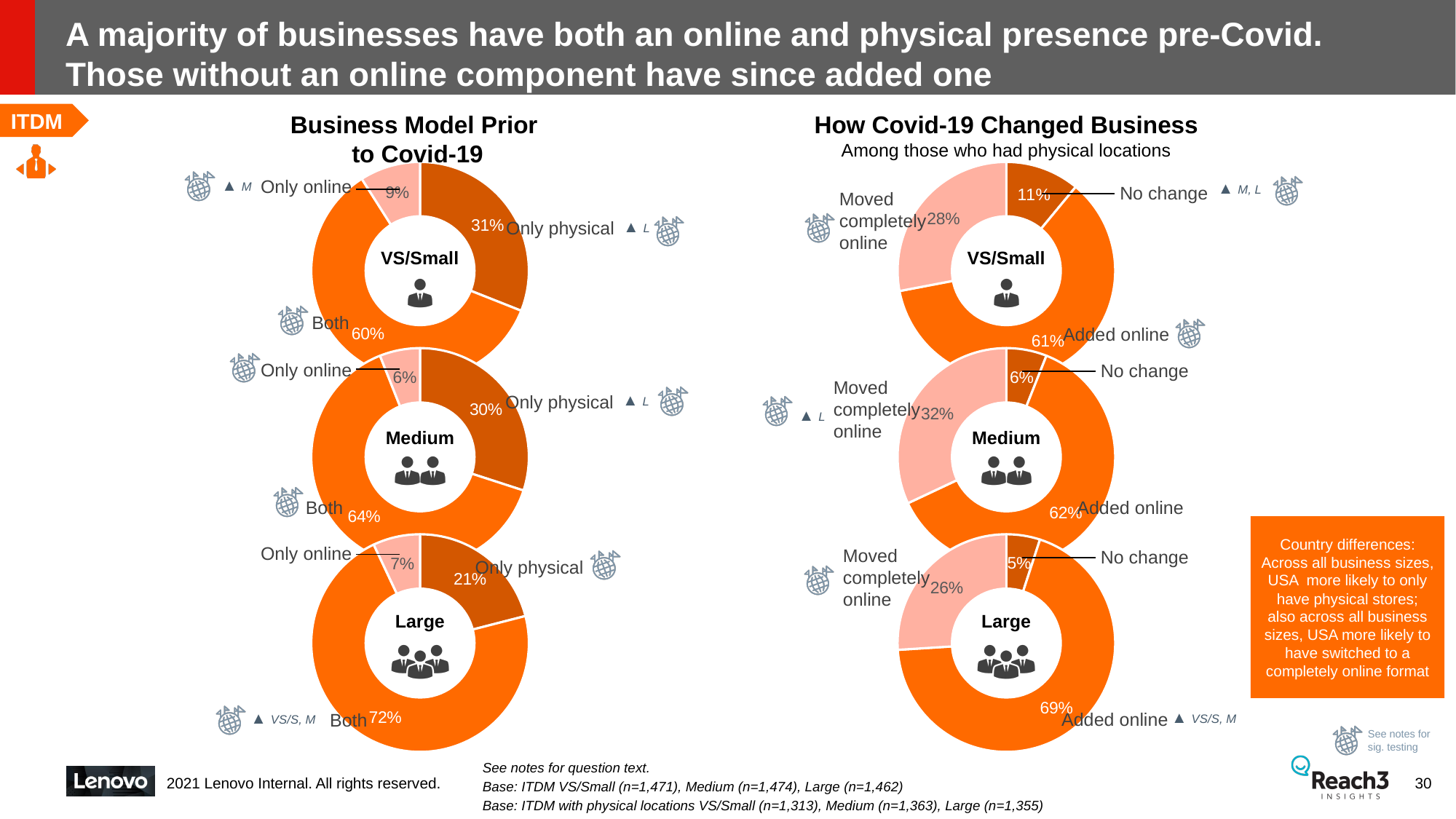
What type of chart is used to show the 'How Covid-19 Changed Business' data? Donut (pie) chart In the 'How Covid-19 Changed Business' chart for Large businesses, which category has the smallest share? No change What is the subtitle under the 'How Covid-19 Changed Business' chart title? Among those who had physical locations In the 'How Covid-19 Changed Business' chart for Medium businesses, what share moved completely online? 32% In the 'How Covid-19 Changed Business' chart for VS/Small businesses, what share reported no change? 11% In the 'How Covid-19 Changed Business' chart, which is larger: the 'Moved completely online' share for VS/Small or for Medium businesses? Medium How many categories does each donut in the 'Business Model Prior to Covid-19' chart show? 3 In the 'Business Model Prior to Covid-19' chart, what is the difference between the 'Both' share for Large businesses and for Medium businesses? 8 percentage points In the 'How Covid-19 Changed Business' chart for Large businesses, what share added online? 69% In the 'Business Model Prior to Covid-19' chart for Large businesses, what share had both an online and physical presence? 72% In the 'Business Model Prior to Covid-19' chart for VS/Small businesses, which category has the largest share? Both In the 'Business Model Prior to Covid-19' chart for Medium businesses, what share were only physical? 30%